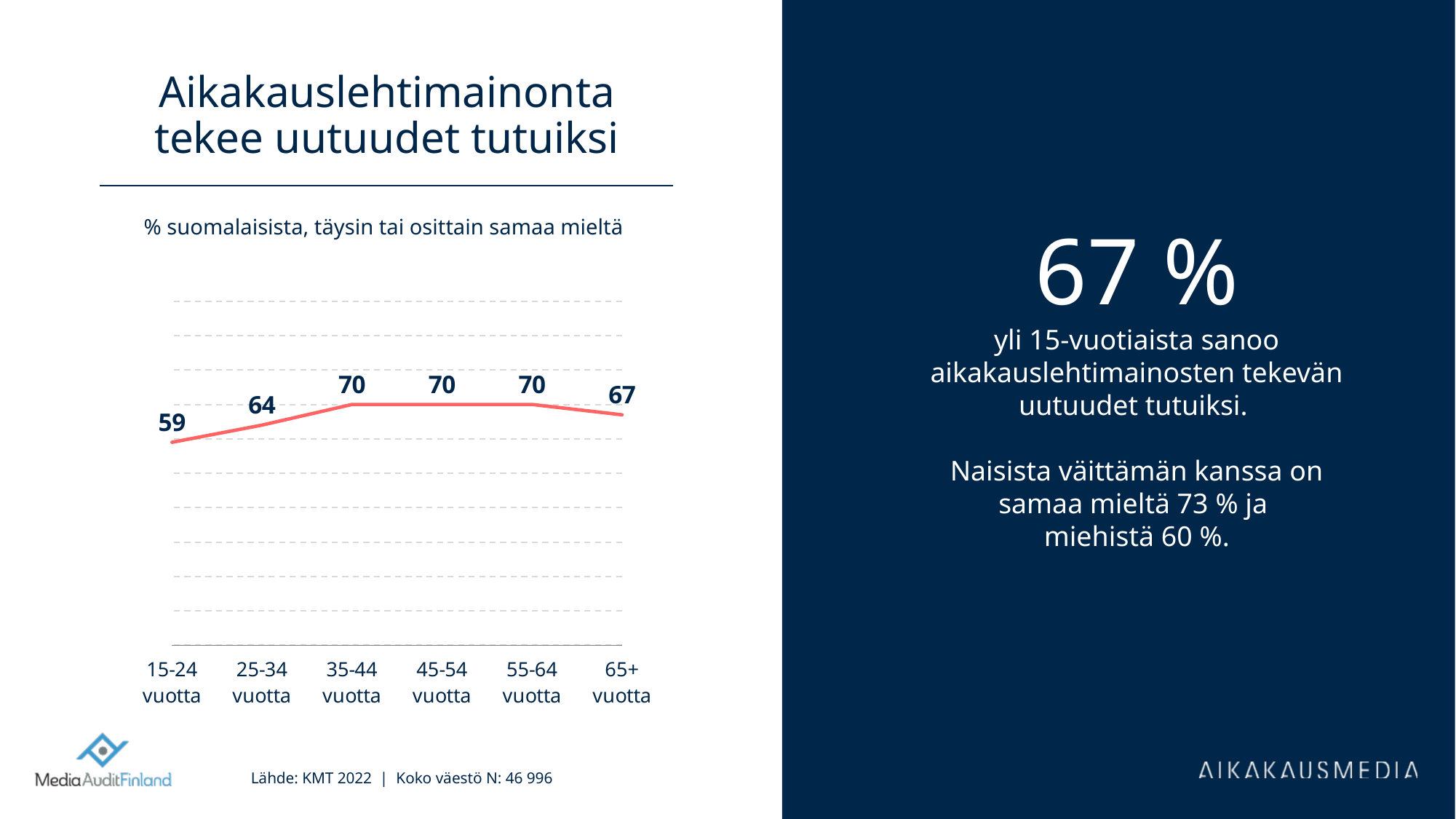
What kind of chart is shown on the slide? Line chart What is the subtitle text shown above the chart? % suomalaisista, täysin tai osittain samaa mieltä Does the value rise or fall from 15-24 vuotta to 35-44 vuotta? Rise Which age group has the lowest value? 15-24 vuotta What is the highest value shown on the chart? 70 What is the difference between the values for 35-44 vuotta and 15-24 vuotta? 11 How many age groups are plotted on the chart? 6 What is the difference between the values for 55-64 vuotta and 65+ vuotta? 3 What is the value for the 15-24 vuotta age group? 59 What is the value for the 65+ vuotta age group? 67 What is the value for the 25-34 vuotta age group? 64 Which is larger, the value for 25-34 vuotta or the value for 65+ vuotta? 65+ vuotta